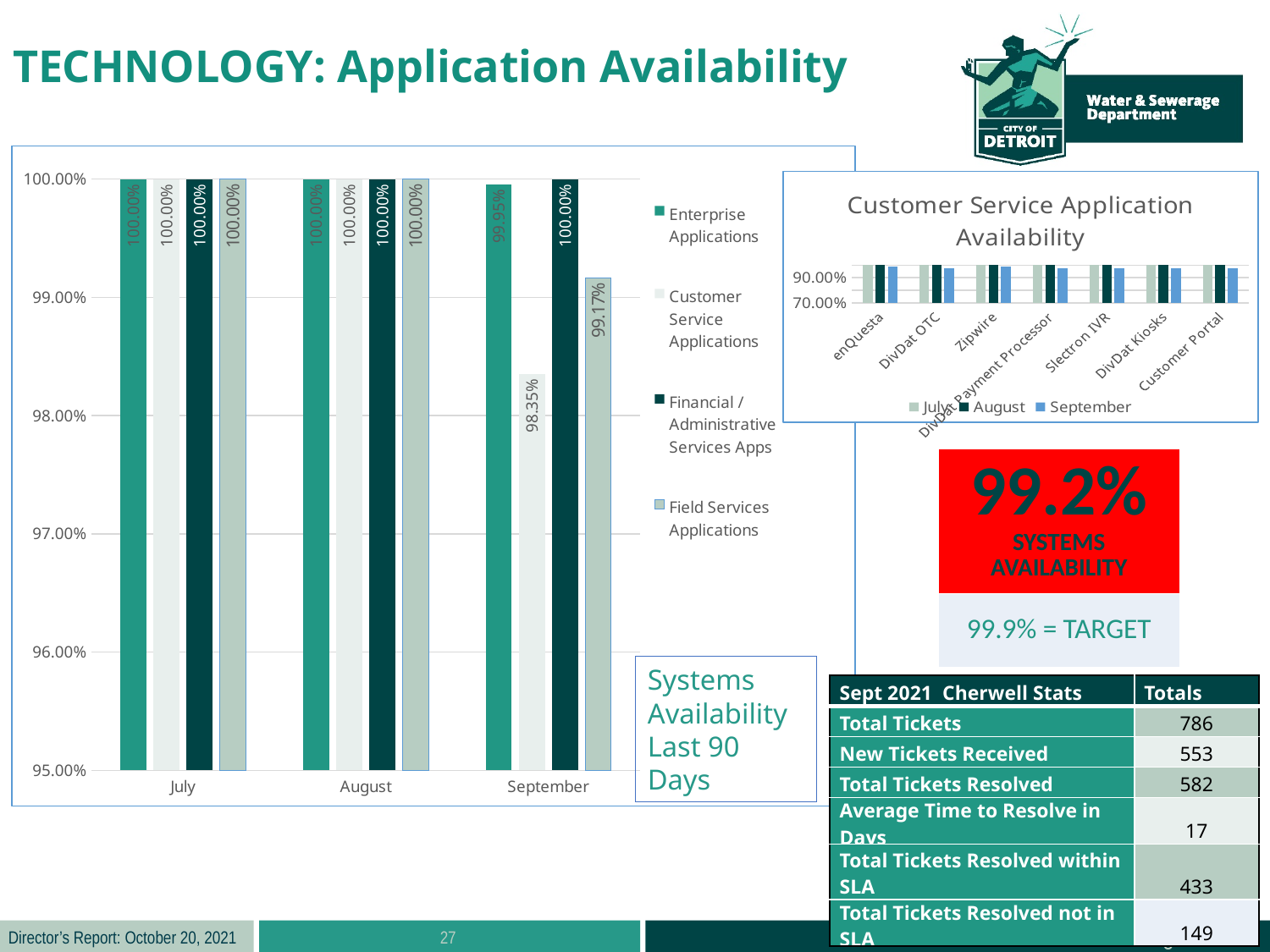
How many months are shown on the x axis of the Systems Availability Last 90 Days chart? 3 In the Systems Availability Last 90 Days chart, which is larger in September: Field Services Applications or Customer Service Applications? Field Services Applications In the Systems Availability Last 90 Days chart, what is the value for Customer Service Applications in September? 98.35% In the Systems Availability Last 90 Days chart, what is the value for Field Services Applications in September? 99.17% How many series does the legend of the Customer Service Application Availability chart list? 3 How many series does the legend of the Systems Availability Last 90 Days chart list? 4 In the Customer Service Application Availability chart, is the value for enQuesta in September greater or less than 90.00%? greater In the Systems Availability Last 90 Days chart, is the value for Customer Service Applications in September greater or less than 99.00%? less What kind of chart is the Customer Service Application Availability chart? bar chart In the Systems Availability Last 90 Days chart, what is the difference between the Enterprise Applications and Customer Service Applications values in September? 1.60% In the Systems Availability Last 90 Days chart, what is the value for Enterprise Applications in September? 99.95% In the Systems Availability Last 90 Days chart, which series has the lowest value in September? Customer Service Applications